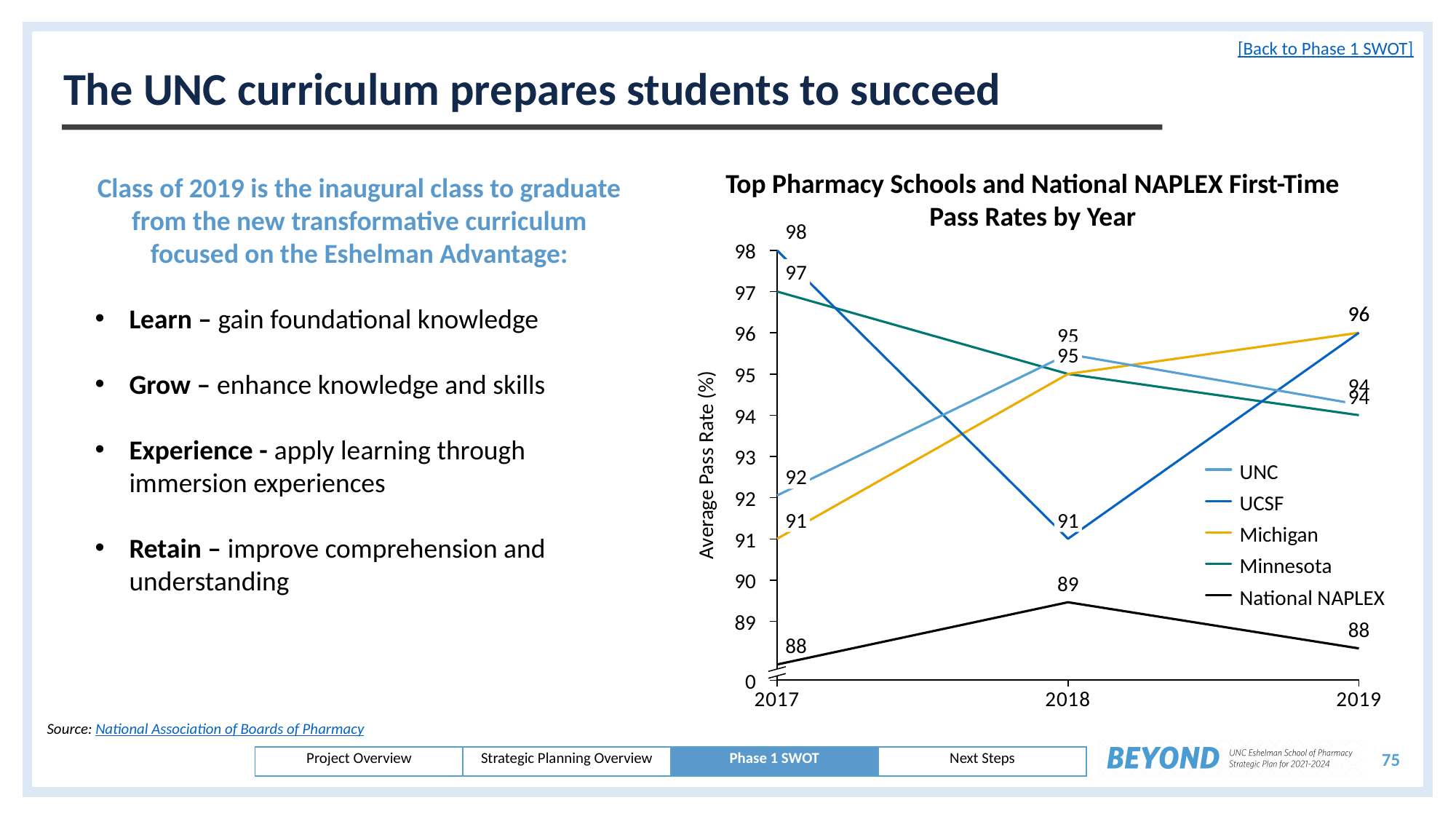
How many series does the legend of the chart list? 5 What was UNC's first-time pass rate in 2017? 92 Which series has the lowest value in every year shown? National NAPLEX By how many points did UCSF's pass rate fall from 2017 to 2018? 7 How many years are plotted on the x axis of the chart? 3 Does Minnesota's pass rate rise or fall from 2017 to 2019? Fall What was UCSF's first-time pass rate in 2017? 98 What was the National NAPLEX first-time pass rate in 2018? 89 What type of chart is shown on the slide? Line chart What is the label of the y axis of the chart? Average Pass Rate (%) What was Minnesota's first-time pass rate in 2017? 97 Which school had the highest first-time pass rate in 2017? UCSF